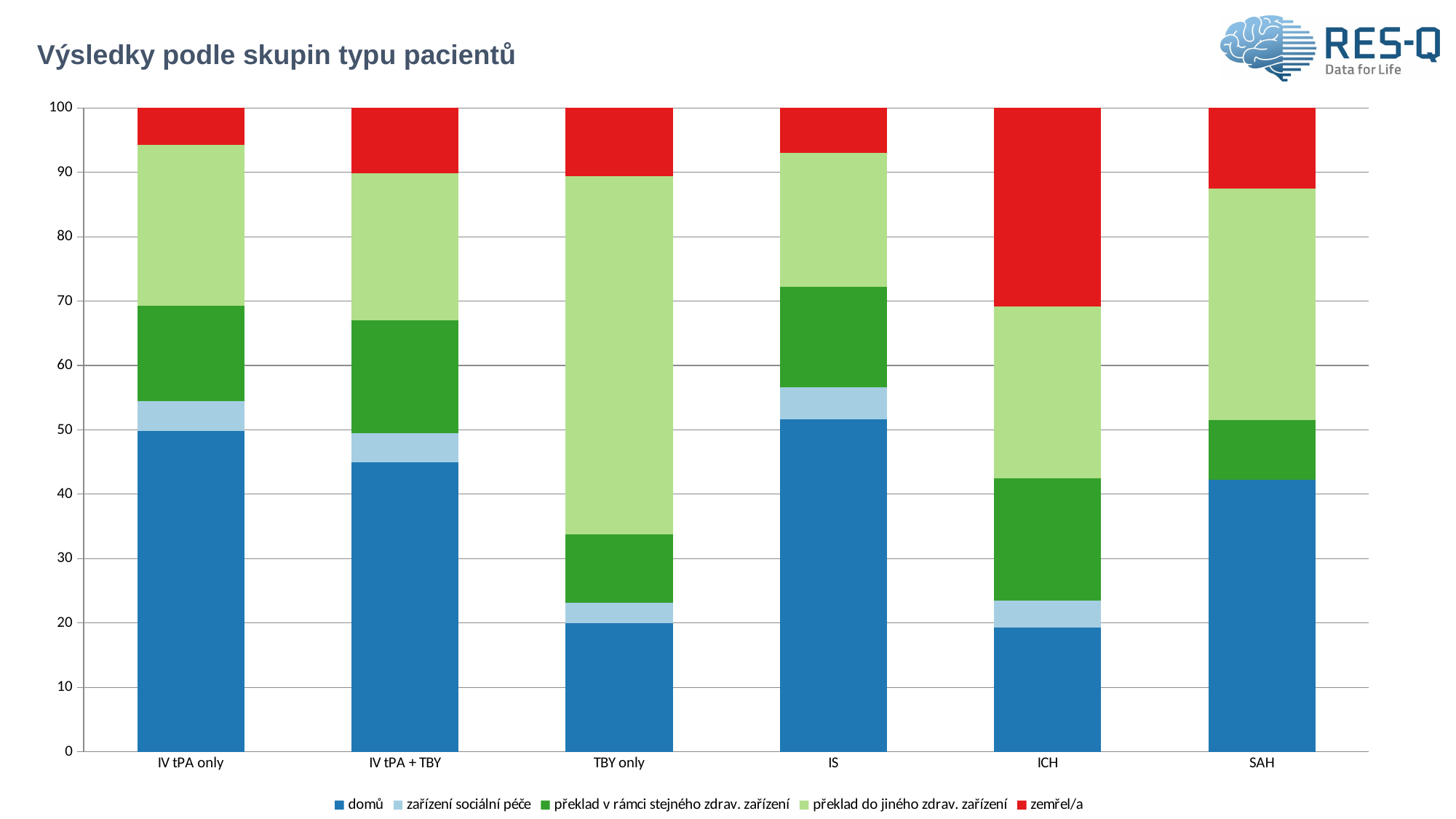
Which series is shown in red in the legend? zemřel/a Which patient group has the largest 'zemřel/a' segment? ICH How many series does the legend list? 5 Which has a larger 'domů' segment, IV tPA only or TBY only? IV tPA only What kind of chart is shown on the slide? stacked bar chart Is the 'domů' value for IV tPA + TBY greater or less than 40? greater Is the 'domů' value for SAH greater or less than 50? less How many patient groups (categories) are shown on the x axis? 6 What is the total height of the stacked bar for ICH? 100 Is the 'domů' value for TBY only greater or less than 30? less Which has a larger 'zemřel/a' segment, ICH or SAH? ICH What is the title of the chart? Výsledky podle skupin typu pacientů